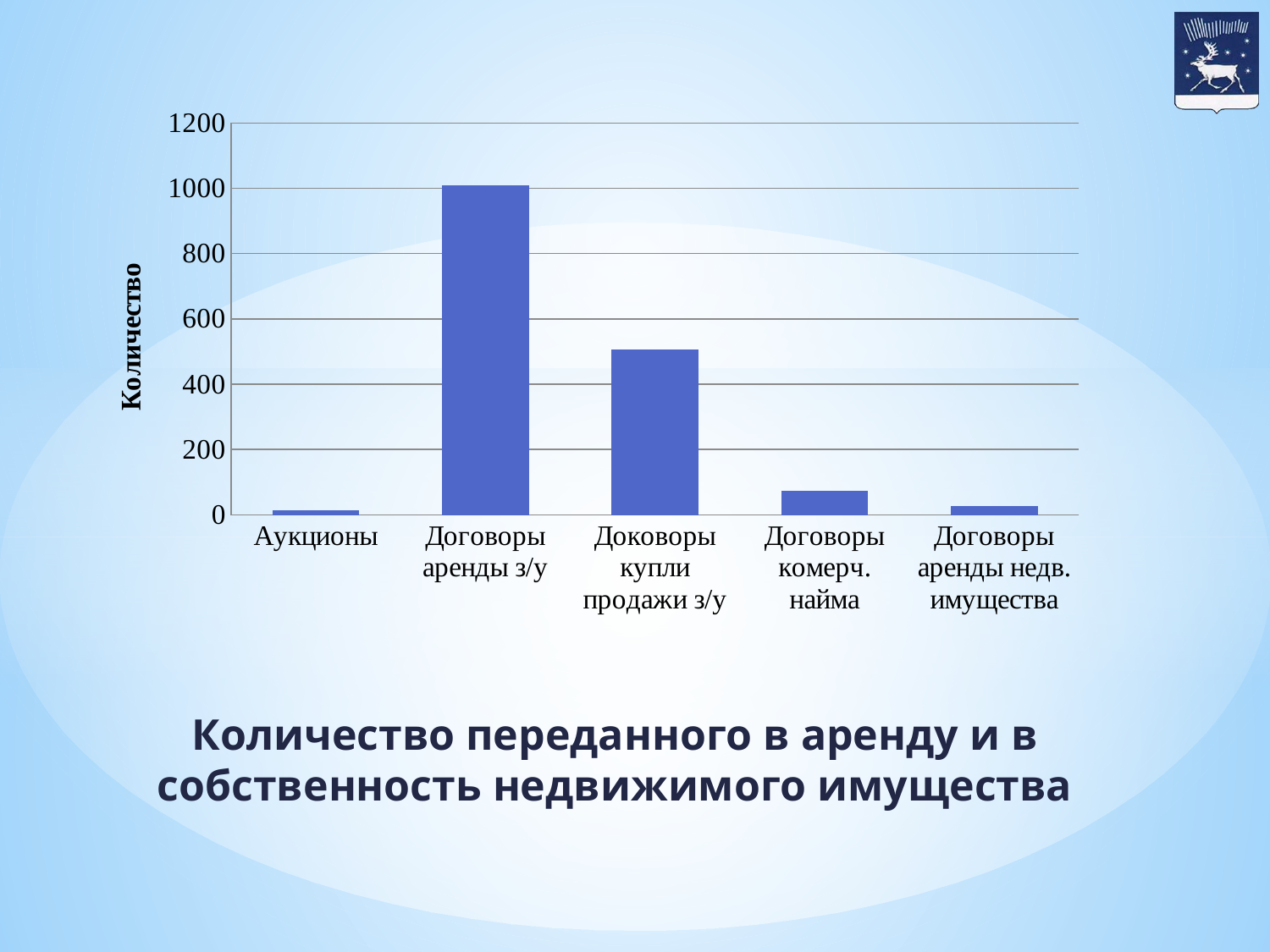
Is the value for Доковоры купли продажи з/у greater or less than 600? less Which is larger, the value for Договоры аренды з/у or the value for Доковоры купли продажи з/у? Договоры аренды з/у Which is larger, the value for Договоры комерч. найма or the value for Аукционы? Договоры комерч. найма Is the value for Договоры комерч. найма greater or less than 200? less Is the value for Договоры аренды з/у greater or less than 800? greater What is the title shown below the chart? Количество переданного в аренду и в собственность недвижимого имущества What kind of chart is shown on the slide? bar chart What is the label of the vertical axis of the chart? Количество Which category has the highest value in the chart? Договоры аренды з/у How many categories are shown on the x axis of the chart? 5